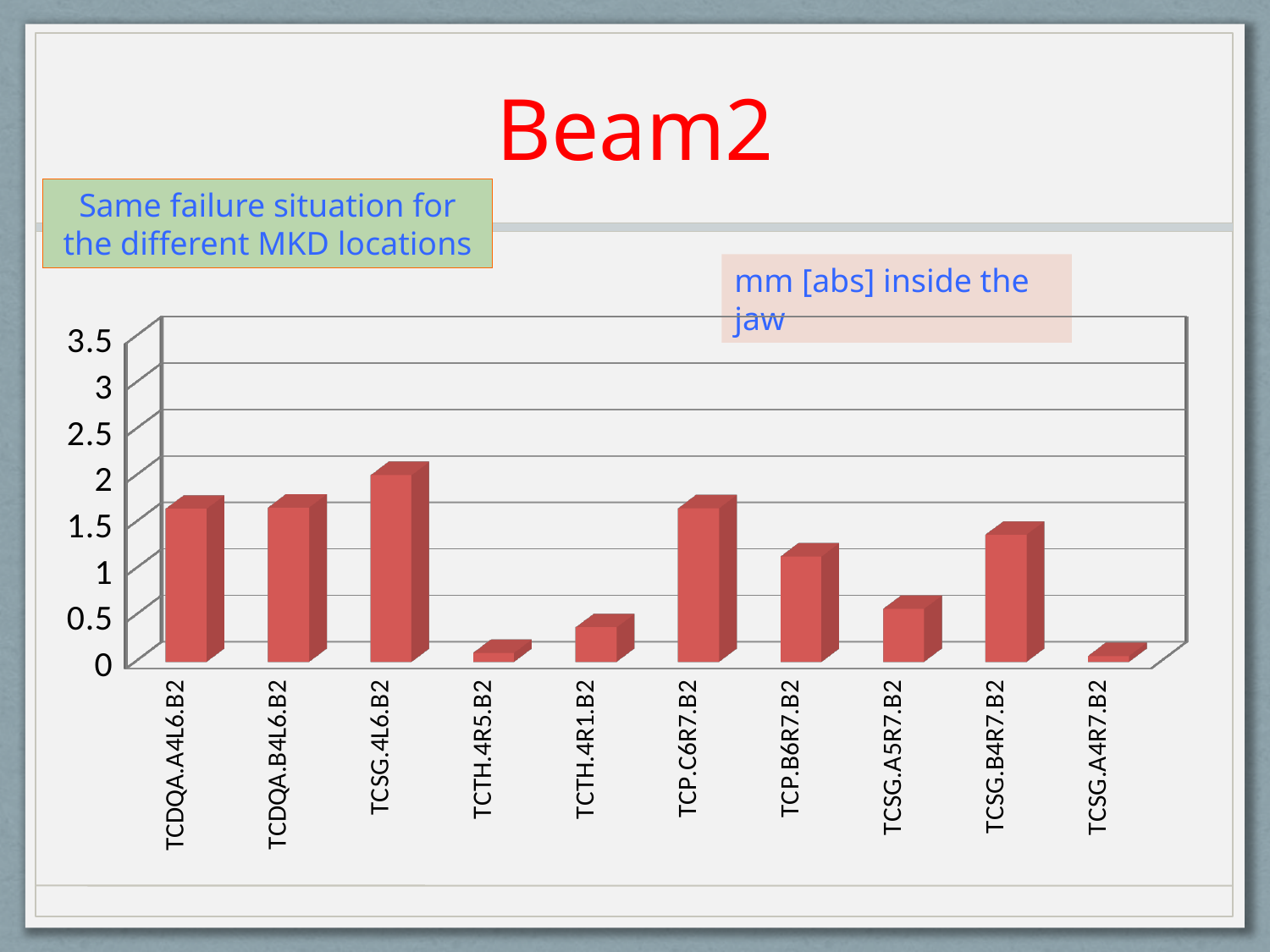
Is the value for TCSG.B4R7.B2 greater or less than 1.5? less Which is larger, the value for TCSG.B4R7.B2 or the value for TCSG.A5R7.B2? TCSG.B4R7.B2 What unit is given for the values in the chart, according to the text box on the slide? mm [abs] inside the jaw Is the value for TCTH.4R1.B2 greater or less than 0.5? less Which is larger, the value for TCSG.4L6.B2 or the value for TCP.B6R7.B2? TCSG.4L6.B2 Is the value for TCSG.A5R7.B2 greater or less than 1? less Which category has the highest bar in the chart? TCSG.4L6.B2 How many categories are plotted on the x axis of the chart? 10 What kind of chart is shown on the slide? bar chart Which is larger, the value for TCTH.4R1.B2 or the value for TCTH.4R5.B2? TCTH.4R1.B2